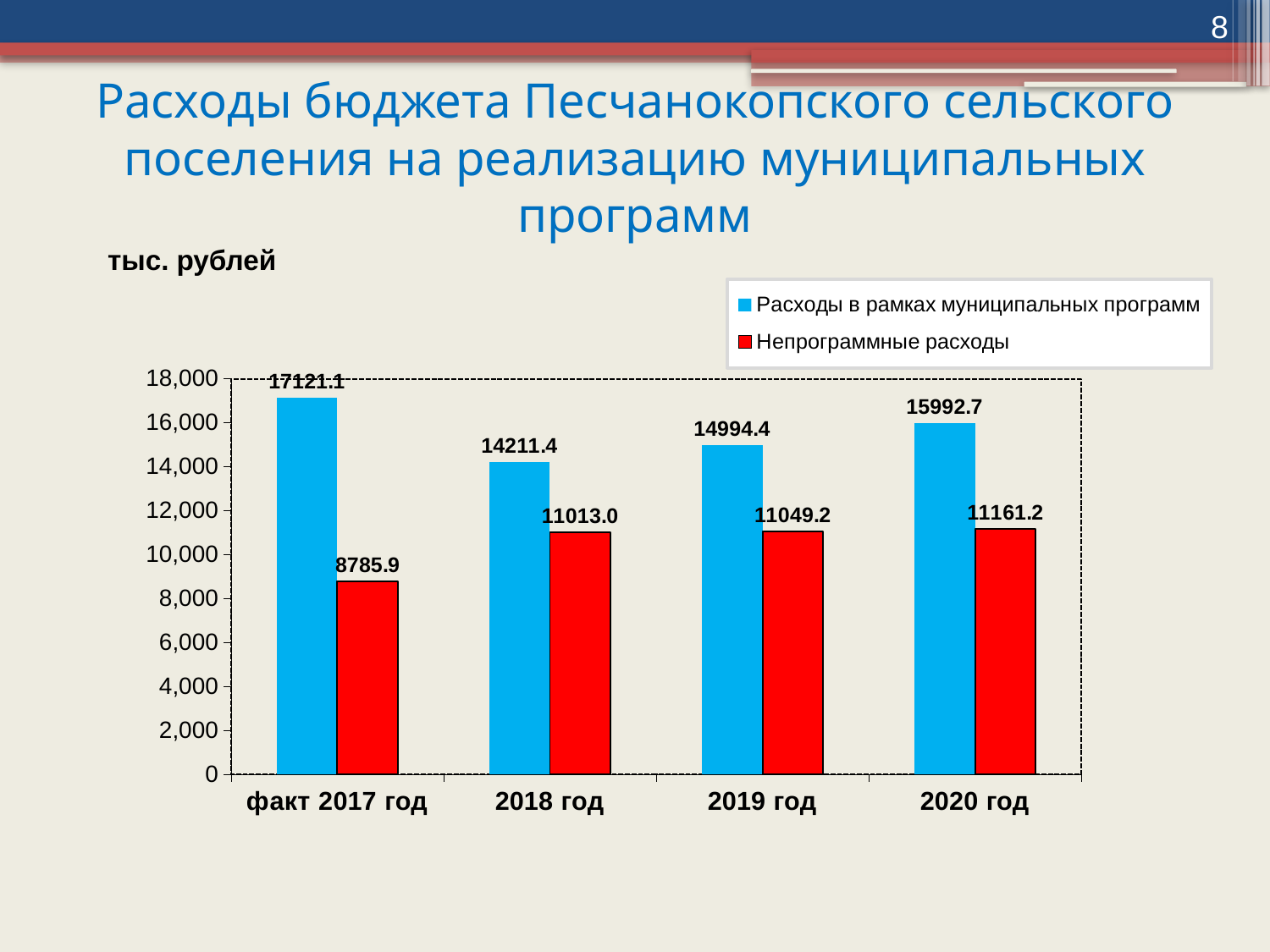
Which category has the lowest value for 'Непрограммные расходы'? факт 2017 год What is the value of 'Непрограммные расходы' for '2018 год'? 11013.0 How many series does the legend list? 2 What is the difference between 'Расходы в рамках муниципальных программ' and 'Непрограммные расходы' for '2019 год'? 3945.2 How many categories are shown on the x axis? 4 What is the value of 'Расходы в рамках муниципальных программ' for 'факт 2017 год'? 17121.1 What kind of chart is shown on the slide? bar chart Is the value of 'Расходы в рамках муниципальных программ' for '2018 год' greater or less than 14,000? greater What colour are the bars for 'Непрограммные расходы'? red Which category has the highest value for 'Расходы в рамках муниципальных программ'? факт 2017 год What is the value of 'Расходы в рамках муниципальных программ' for '2020 год'? 15992.7 Which is larger: 'Непрограммные расходы' for '2020 год' or for '2018 год'? 2020 год